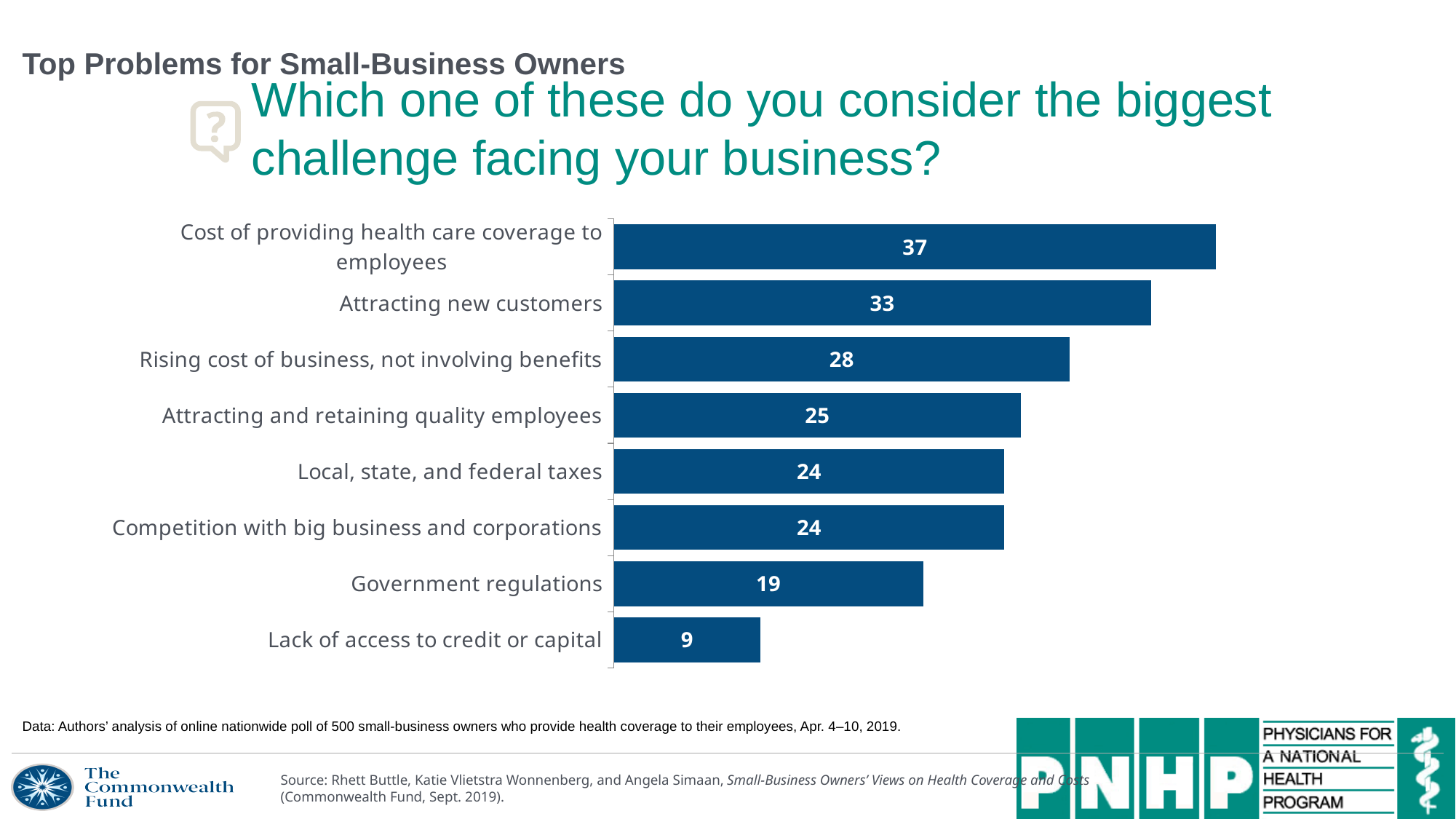
How many categories are shown in the chart? 8 Which category has the highest value? Cost of providing health care coverage to employees What is the value for "Rising cost of business, not involving benefits"? 28 What kind of chart is shown on the slide? Bar chart What is the value for "Lack of access to credit or capital"? 9 Which is larger: the value for "Rising cost of business, not involving benefits" or the value for "Government regulations"? Rising cost of business, not involving benefits What is the value for "Government regulations"? 19 Which two categories share the same value of 24? Local, state, and federal taxes; Competition with big business and corporations What is the value for "Attracting new customers"? 33 What is the difference between the values for "Attracting and retaining quality employees" and "Lack of access to credit or capital"? 16 Which category has the lowest value? Lack of access to credit or capital What is the difference between the values for "Cost of providing health care coverage to employees" and "Attracting new customers"? 4